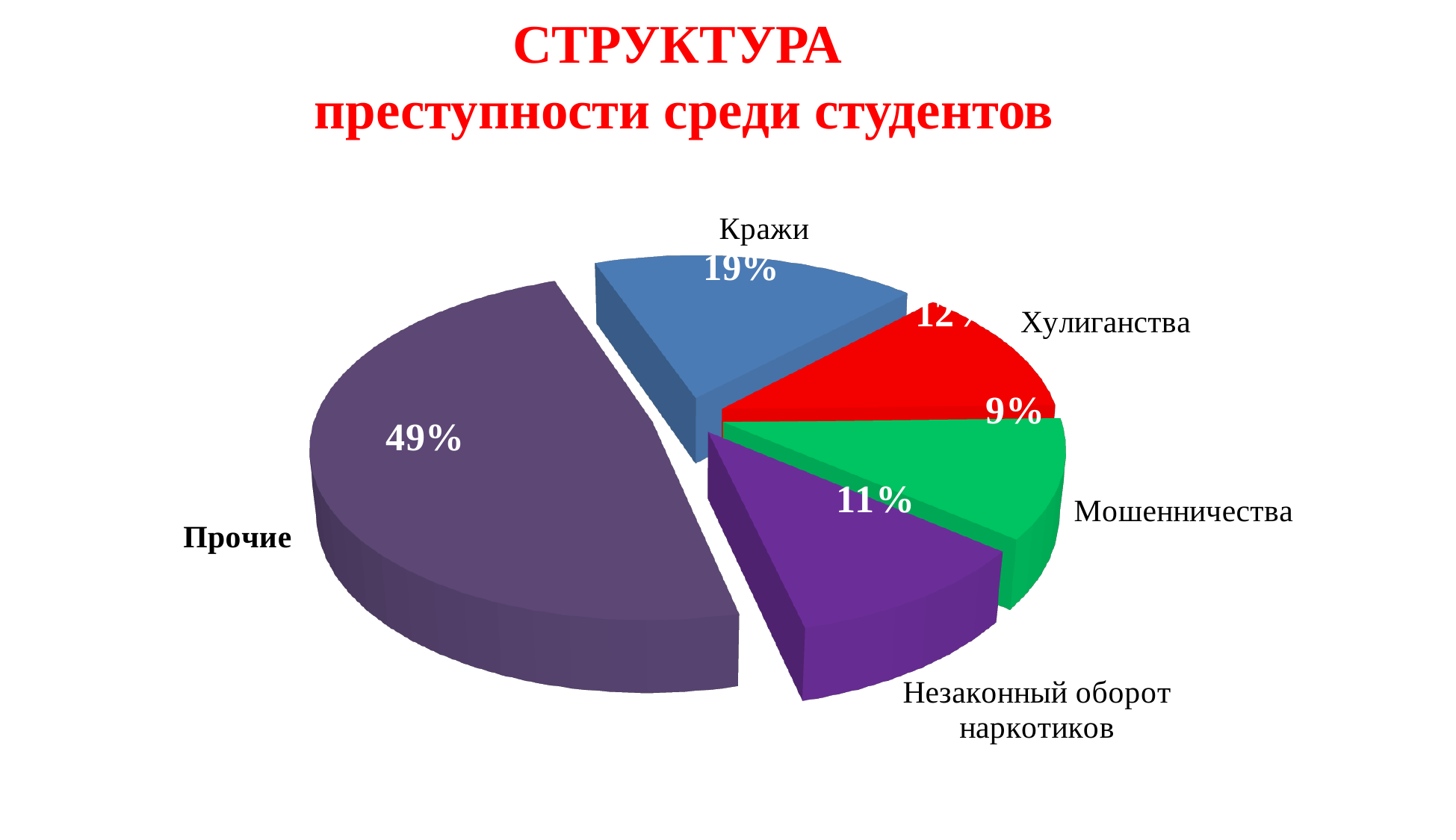
What is the difference between the Прочие share and the Кражи share? 30% How many slices does the pie chart have? 5 What percentage does the Незаконный оборот наркотиков slice show? 11% What percentage does the Мошенничества slice show? 9% Which is larger: the share for Кражи or the share for Незаконный оборот наркотиков? Кражи What kind of chart is shown on the slide? pie chart What is the difference between the Кражи share and the Мошенничества share? 10% What percentage does the Кражи slice show? 19% What is the title of the slide? СТРУКТУРА преступности среди студентов Which category has the largest share of the pie? Прочие What percentage does the Прочие slice show? 49% Which category has the smallest share of the pie? Мошенничества